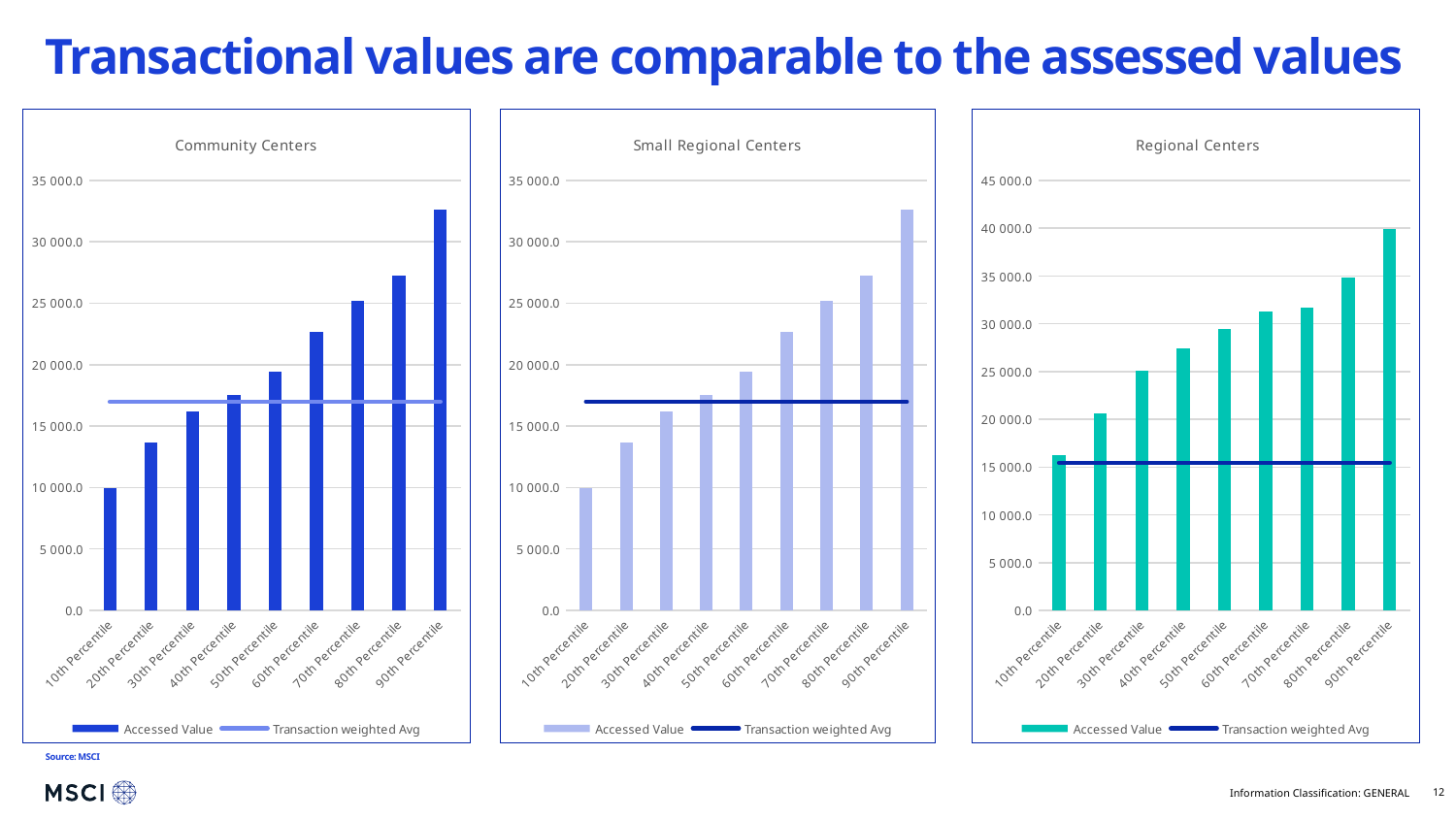
In the Small Regional Centers chart, is the Accessed Value for the 80th Percentile greater or less than 25 000.0? greater In the Community Centers chart, is the Transaction weighted Avg line greater or less than 20 000.0? less How many percentile categories are shown on the x axis of the Small Regional Centers chart? 9 What kind of chart is the Community Centers chart? combination bar and line chart In the Community Centers chart, which percentile has the highest Accessed Value? 90th Percentile In the Community Centers chart, is the Accessed Value for the 90th Percentile greater or less than 30 000.0? greater How many series does the legend of the Regional Centers chart list? 2 In the Community Centers chart, which percentile has the lowest Accessed Value? 10th Percentile In the Regional Centers chart, do the Accessed Values rise or fall from the 10th Percentile to the 90th Percentile? rise